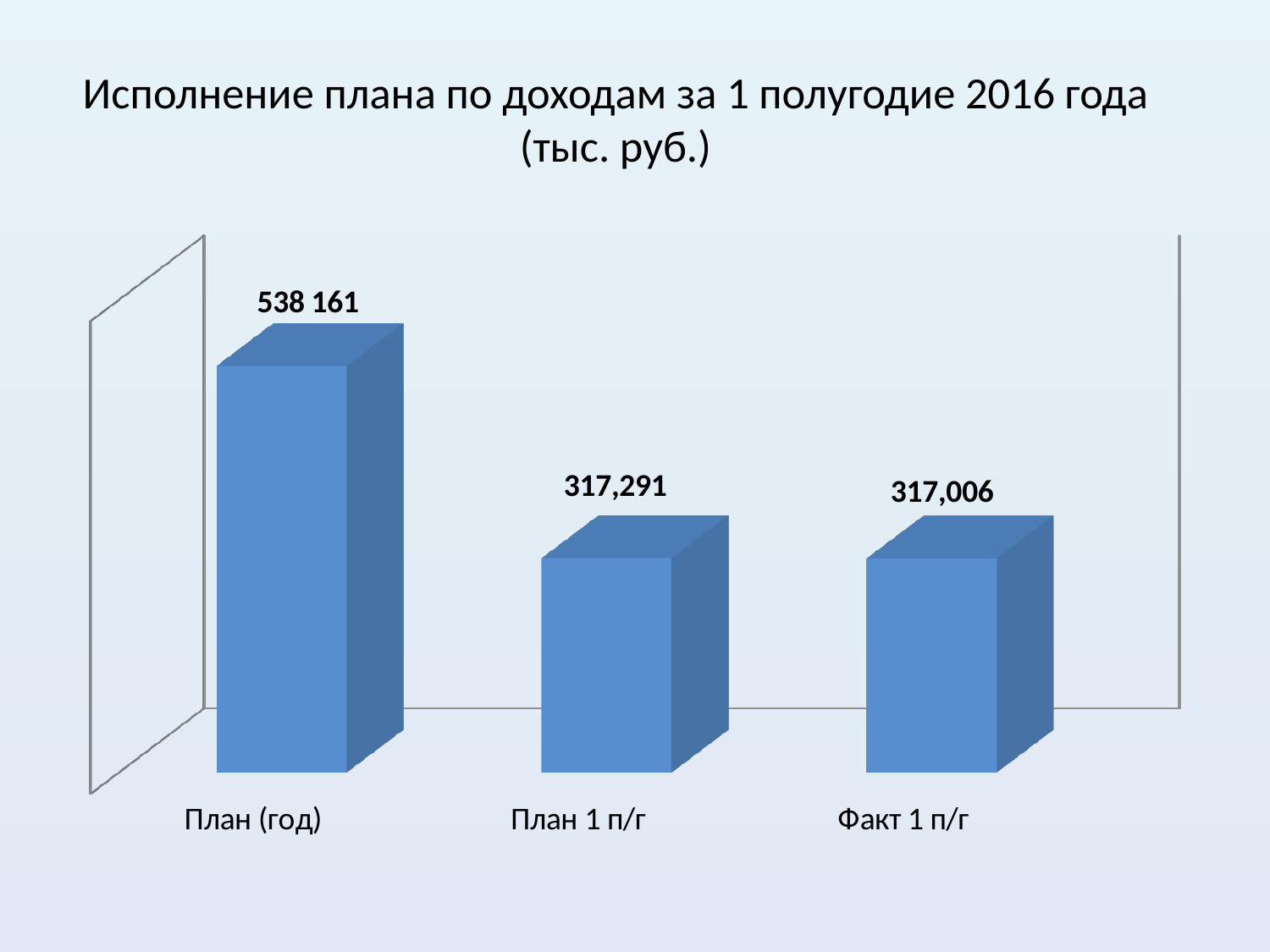
Which category has the highest value? План (год) What kind of chart is shown on the slide? Bar chart What is the value for Факт 1 п/г? 317,006 Which is larger, the value for План (год) or the value for План 1 п/г? План (год) Which is larger, the value for План (год) or the value for Факт 1 п/г? План (год) What is the title of the chart? Исполнение плана по доходам за 1 полугодие 2016 года (тыс. руб.) What is the value for План (год)? 538 161 What is the value for План 1 п/г? 317,291 Do the values rise or fall from left to right across the categories? Fall How many categories are shown in the chart? 3 What colour are the bars in the chart? Blue